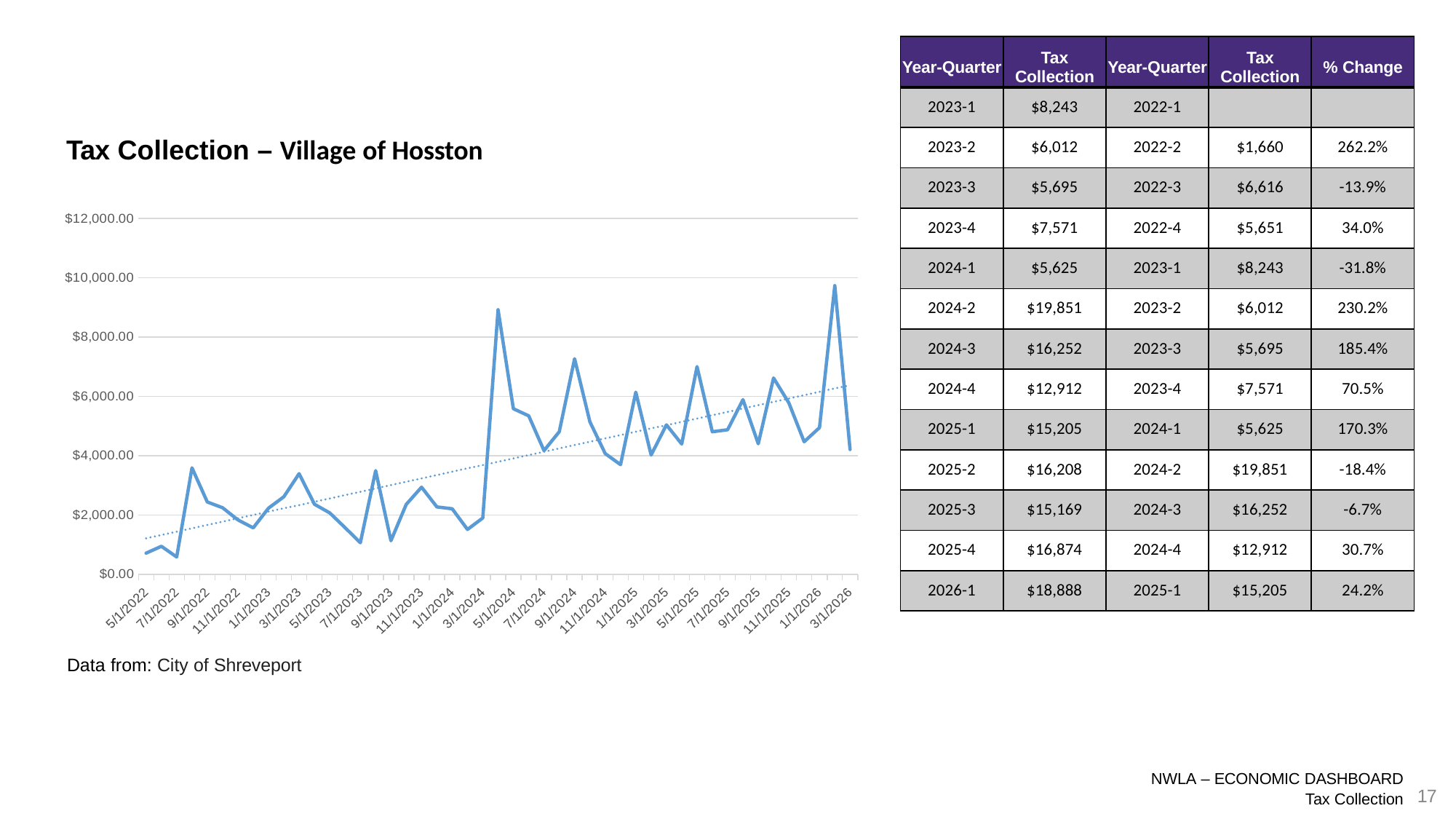
How many date labels are shown along the x axis? 24 What kind of chart is shown on the slide? line chart Which is larger, the value for 5/1/2024 or the value for 5/1/2022? 5/1/2024 Is the value for 5/1/2022 greater or less than $2,000? less Is the value for 5/1/2024 greater or less than $8,000? less Is the value for 7/1/2023 greater or less than $2,000? less What is the title of the chart? Tax Collection – Village of Hosston What is the highest value shown on the chart's y axis? $12,000.00 Does the dotted trend line rise or fall from left to right across the chart? rise